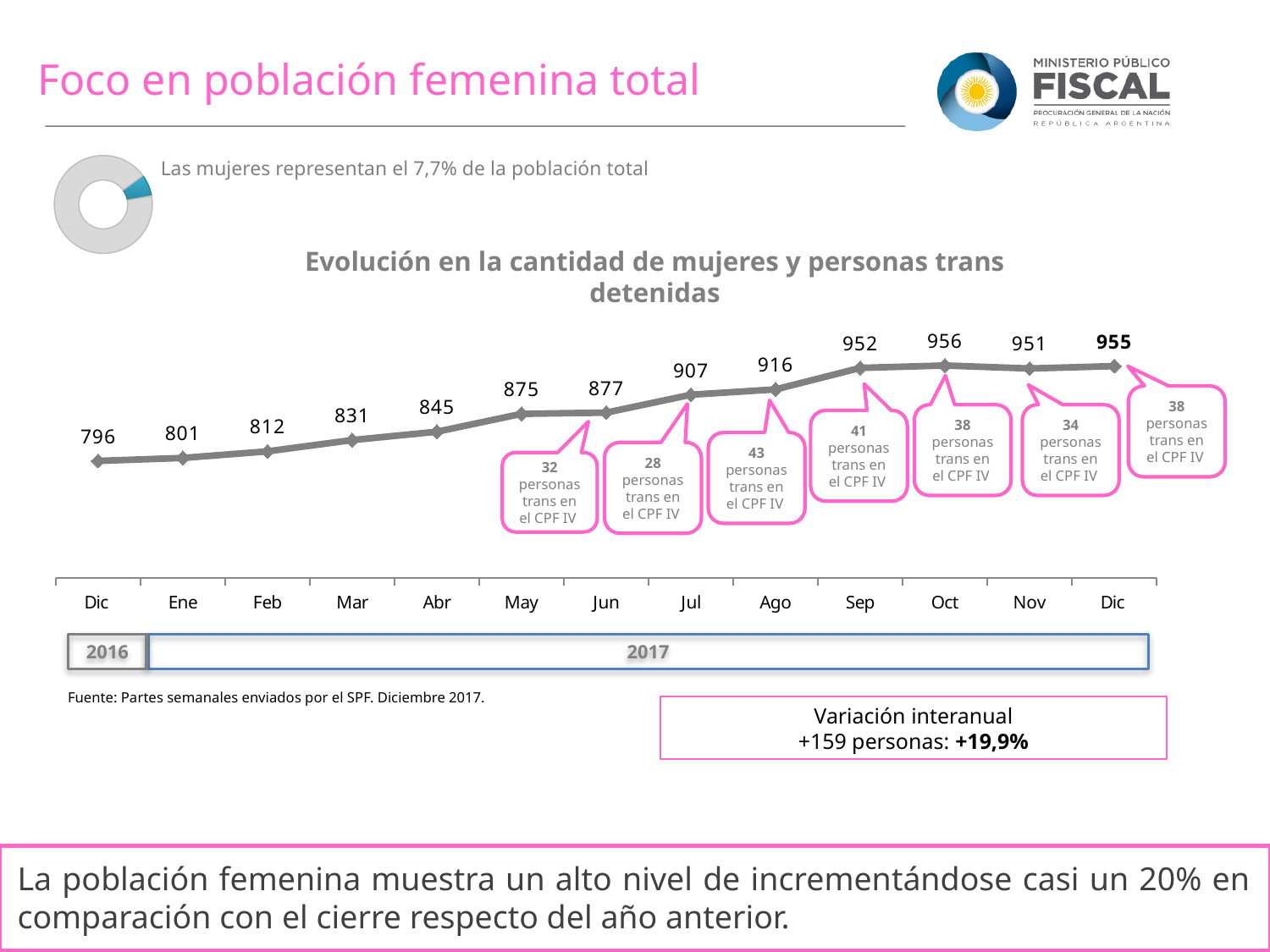
In the chart 'Evolución en la cantidad de mujeres y personas trans detenidas', which month has the lowest value? Dic 2016 In the chart 'Evolución en la cantidad de mujeres y personas trans detenidas', which is larger, the value for Sep or the value for Nov? Sep According to the callout on the chart 'Evolución en la cantidad de mujeres y personas trans detenidas', how many personas trans were in CPF IV in Ago? 43 In the chart 'Evolución en la cantidad de mujeres y personas trans detenidas', which month has the highest value? Oct In the chart 'Evolución en la cantidad de mujeres y personas trans detenidas', what is the value for Dic 2017? 955 In the chart 'Evolución en la cantidad de mujeres y personas trans detenidas', do the values generally rise or fall from Dic 2016 to Dic 2017? Rise What kind of chart is 'Evolución en la cantidad de mujeres y personas trans detenidas'? Line chart In the chart 'Evolución en la cantidad de mujeres y personas trans detenidas', what is the value for Jul 2017? 907 In the chart 'Evolución en la cantidad de mujeres y personas trans detenidas', what is the value for Dic 2016? 796 According to the small donut chart, what percentage of the total population do women represent? 7,7% In the chart 'Evolución en la cantidad de mujeres y personas trans detenidas', what is the difference between the values for Dic 2017 and Dic 2016? 159 In the chart 'Evolución en la cantidad de mujeres y personas trans detenidas', how many monthly data points are plotted? 13